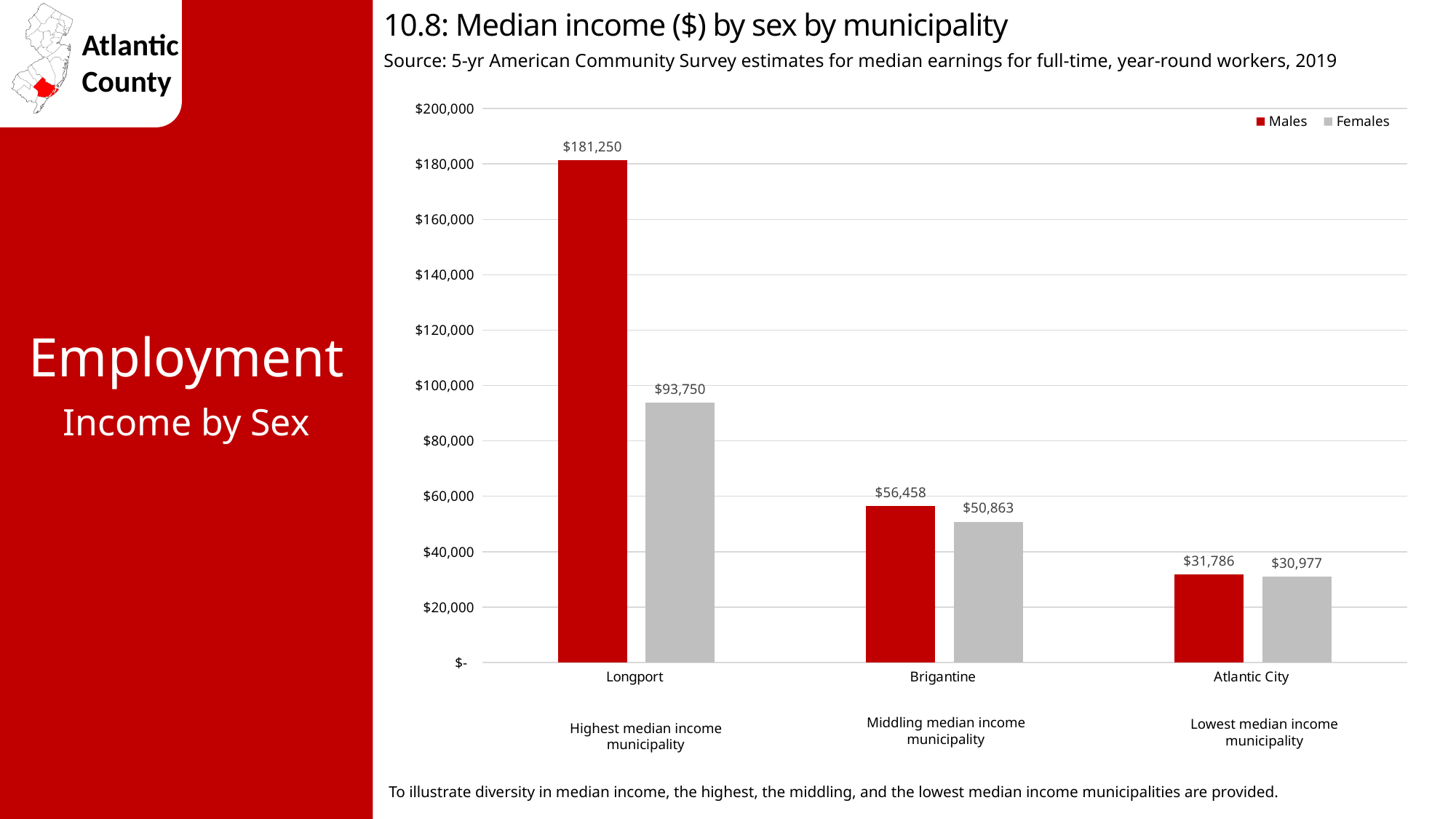
Which municipality has the lowest median income for Females? Atlantic City Which colour represents Females in the chart? Grey What is the median income for Females in Brigantine? $50,863 What is the median income for Females in Atlantic City? $30,977 What is the difference between the Males and Females median income in Longport? $87,500 What is the median income for Males in Longport? $181,250 Which is larger in Brigantine, the Males or the Females median income? Males What kind of chart is shown on the slide? Bar chart What is the difference between the Males and Females median income in Brigantine? $5,595 How many municipalities are shown on the chart? 3 How many series does the legend list? 2 Which municipality has the highest median income for Males? Longport